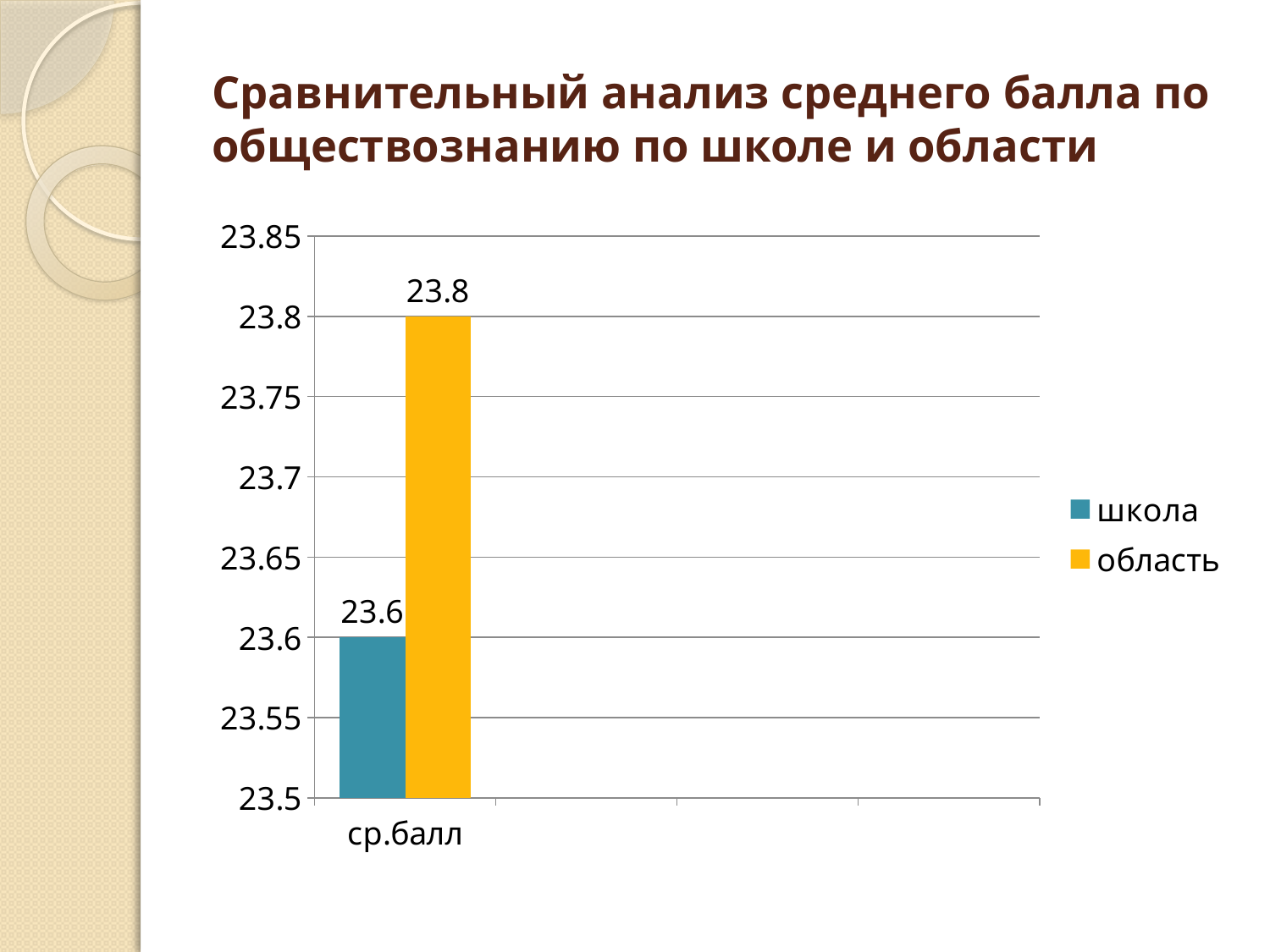
What is the value for область? 23.8 What is the value for школа? 23.6 How many series does the legend list? 2 Which series has the higher value, школа or область? область What is the category label on the x axis? ср.балл Which series has the highest value? область What kind of chart is shown on the slide? bar chart Which series has the lowest value? школа Is the value for школа greater or less than 23.7? less Is the value for область greater or less than 23.7? greater What is the difference between the values for область and школа? 0.2 What colour is the bar for область? yellow